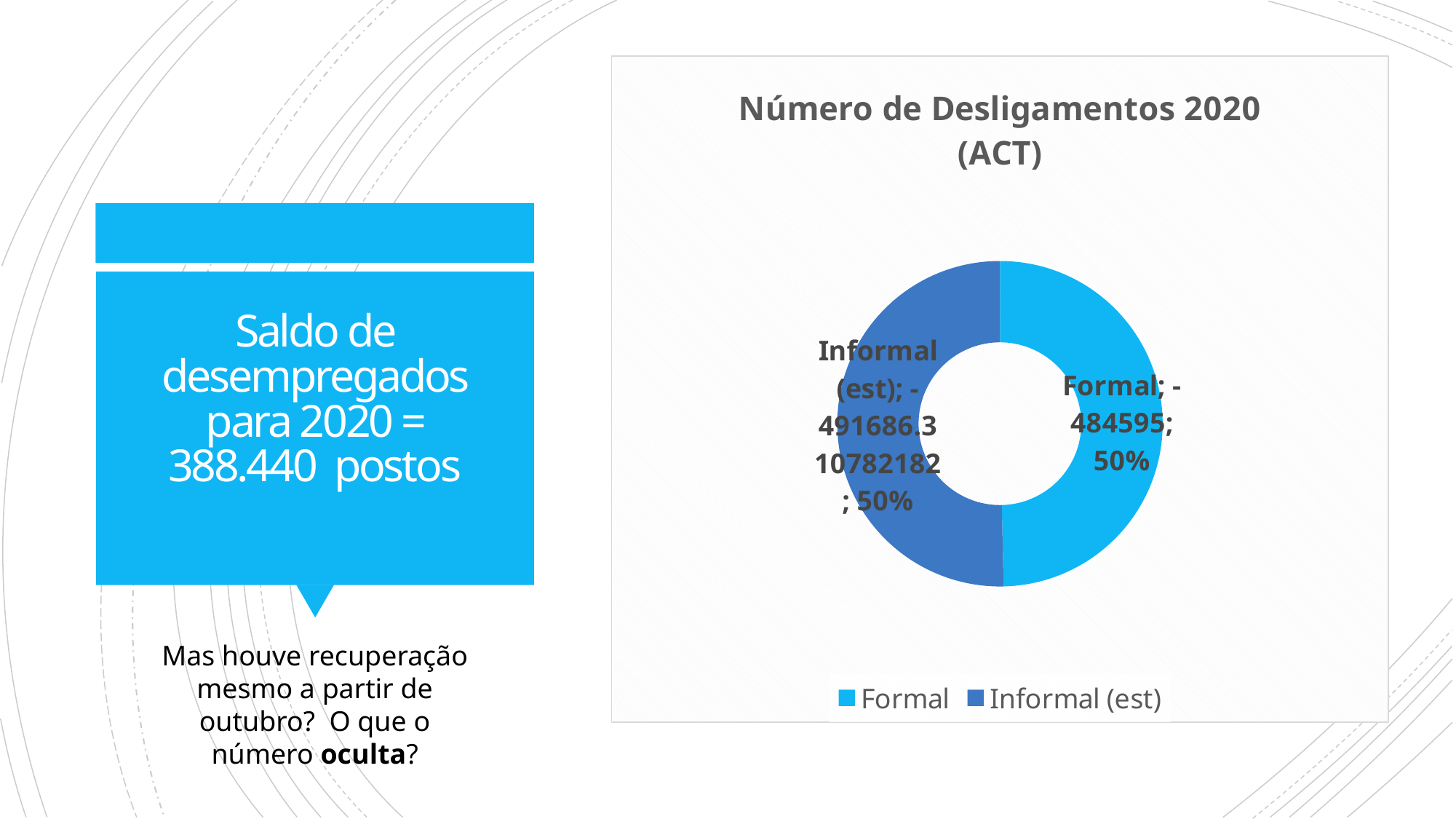
What is the title of the chart? Número de Desligamentos 2020 (ACT) How many entries does the chart legend list? 2 What is the difference in magnitude between the Informal (est) value and the Formal value? 7091.310782182 What value is shown for the Informal (est) slice in the chart? -491686.310782182 What percentage share does the Informal (est) slice have? 50% Which slice has the larger magnitude of desligamentos, Formal or Informal (est)? Informal (est) What percentage share does the Formal slice have? 50% How many slices does the chart have? 2 What value is shown for the Formal slice in the chart? -484595 Which colour represents the Formal slice in the chart? Light blue What kind of chart is shown on the slide? Doughnut (pie) chart